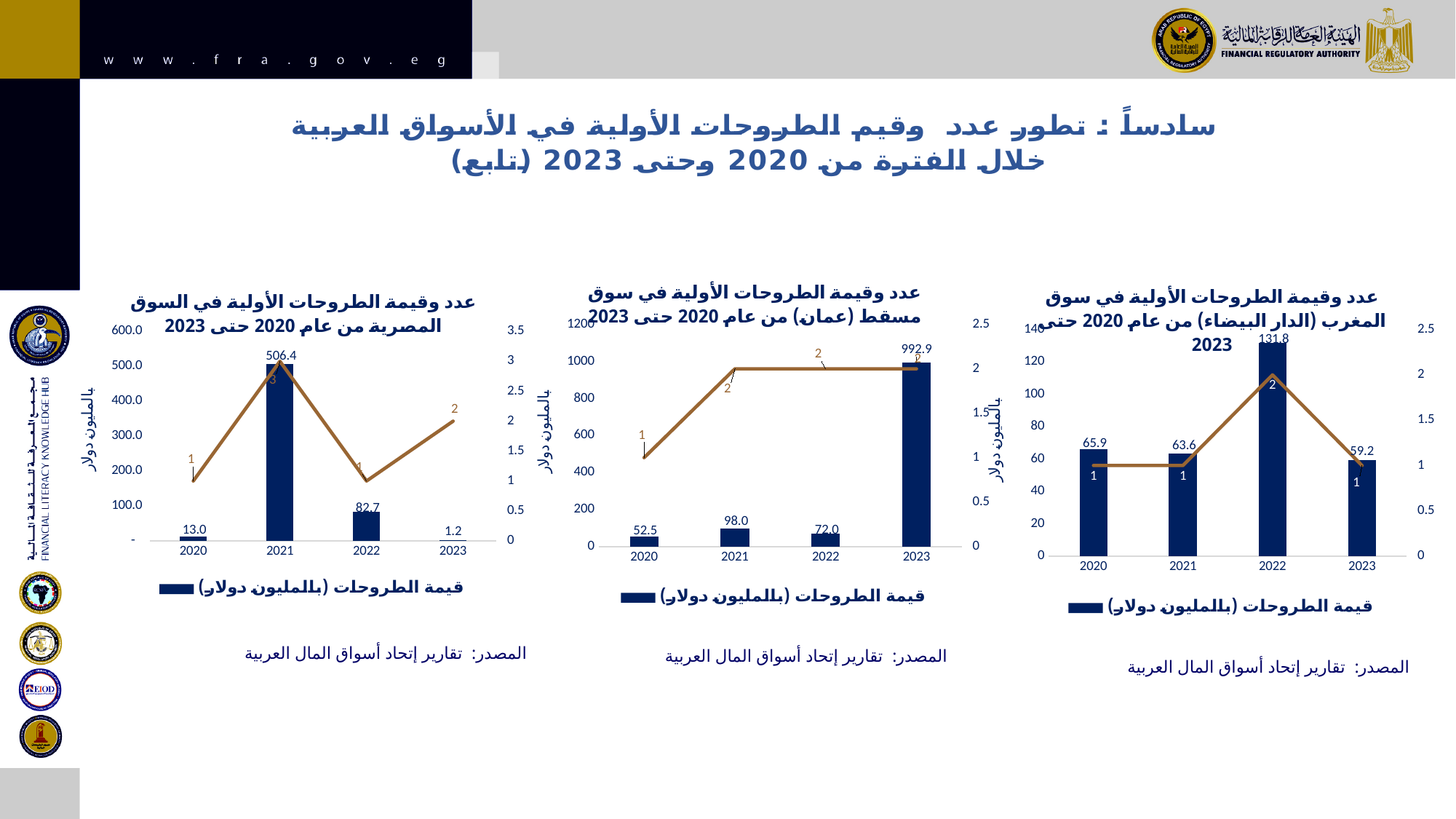
In the left chart (Egyptian market), what is the value of IPOs in 2021? 506.4 In the middle chart (Muscat market), which year has the highest IPO value? 2023 In the middle chart (Muscat market), what is the IPO value for 2023? 992.9 In the left chart (Egyptian market), which year has the lowest IPO value? 2023 How many years are shown on the x axis of the middle chart (Muscat market)? 4 What type of chart is used for the IPO values in the left chart (Egyptian market)? bar chart In the middle chart (Muscat market), is the IPO value for 2021 greater or less than the value for 2022? greater In the left chart (Egyptian market), how many IPOs does the line show for 2021? 3 In the right chart (Morocco market), what is the difference between the IPO values for 2020 and 2021? 2.3 In the left chart (Egyptian market), what is the difference between the IPO values for 2021 and 2022? 423.7 In the right chart (Morocco market), what is the IPO value for 2022? 131.8 In the right chart (Morocco market), which year has the lowest IPO value? 2023